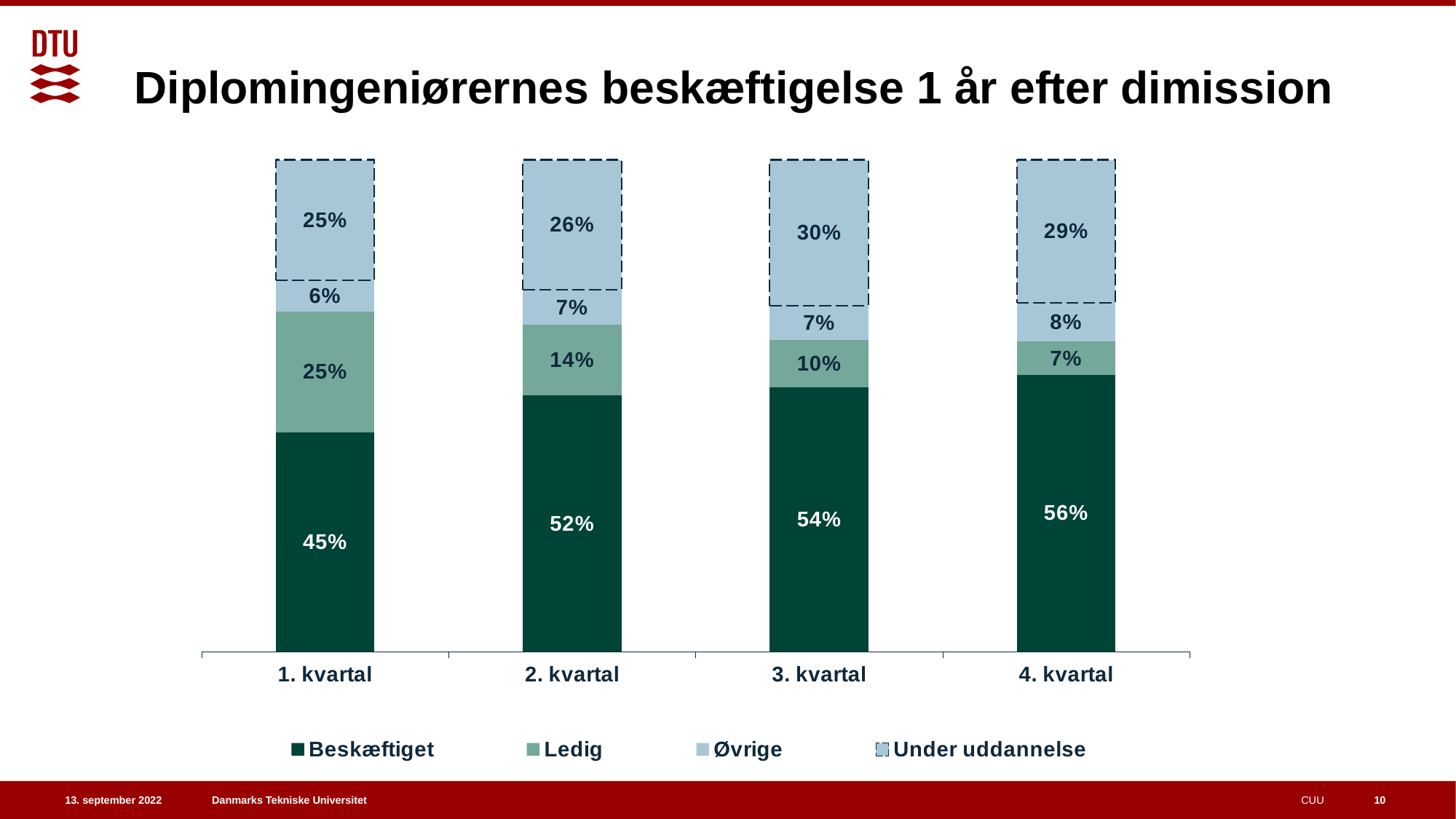
What is the Beskæftiget share for 1. kvartal? 45% Which is larger: the Ledig share in 1. kvartal or the Under uddannelse share in 2. kvartal? Under uddannelse in 2. kvartal Does the Beskæftiget share rise or fall from 1. kvartal to 4. kvartal? Rise What is the Under uddannelse share for 3. kvartal? 30% How many quarters are shown on the x axis? 4 What kind of chart is shown on the slide? Stacked bar chart What is the Øvrige share for 4. kvartal? 8% What is the difference between the Beskæftiget share in 4. kvartal and in 1. kvartal? 11 percentage points What is the Ledig share for 2. kvartal? 14% How many series does the legend list? 4 Which quarter has the lowest Ledig share? 4. kvartal Which quarter has the highest Beskæftiget share? 4. kvartal